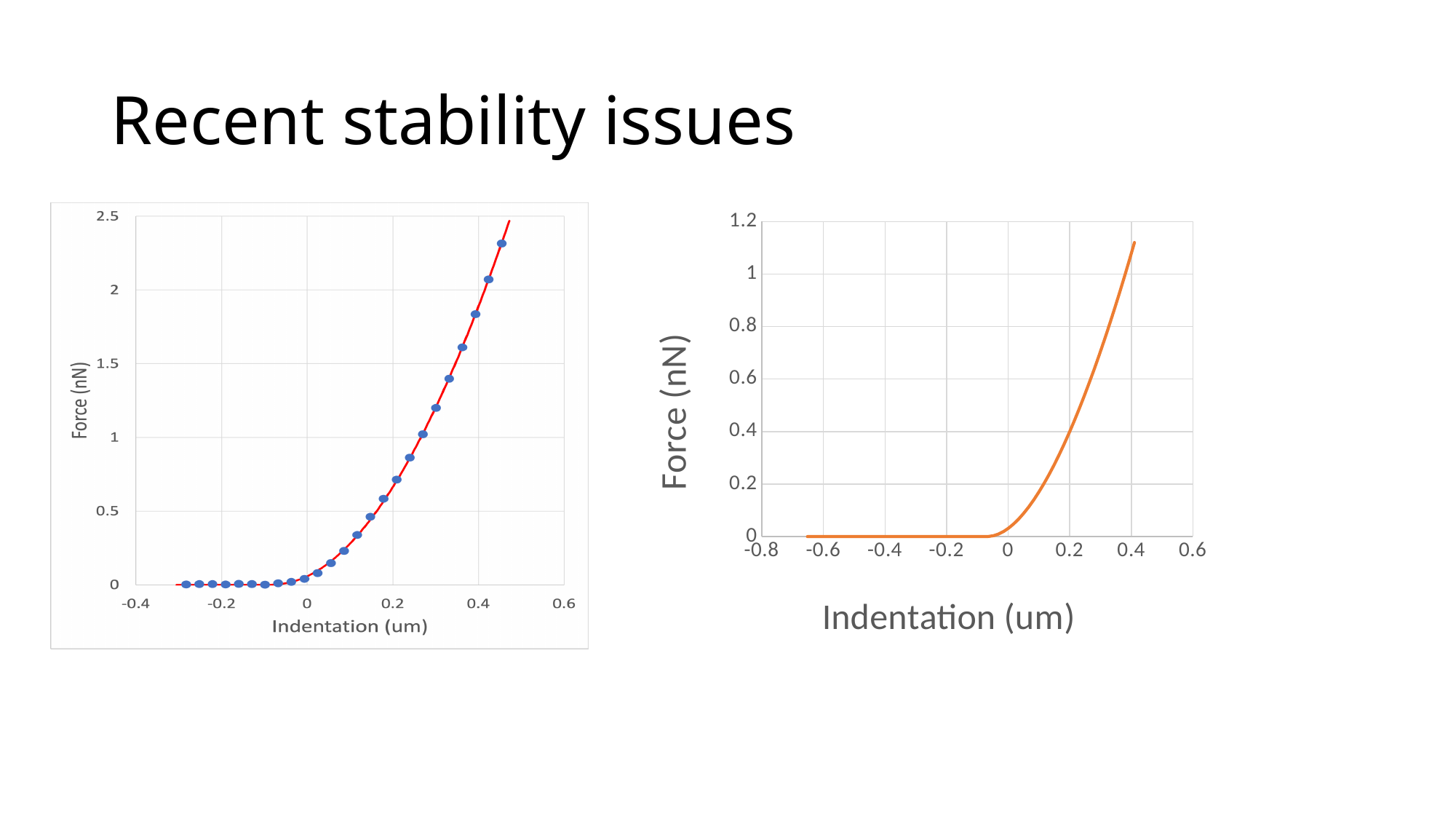
In the chart on the right, is the force at an indentation of -0.4 um greater or less than 0.2 nN? less What is the label of the y axis on the chart on the right? Force (nN) In the chart on the left, is the force at an indentation of 0.4 um greater or less than 1.5 nN? greater What kind of chart is the chart on the left of the slide? scatter chart with a fitted line In the chart on the left, does the force rise or fall as indentation increases from 0 to 0.4 um? rise In the chart on the left, is the force at an indentation of 0.2 um greater or less than 1 nN? less What colour is the line plotted in the chart on the right? orange In the chart on the right, does the force rise or fall as indentation increases from 0 to 0.4 um? rise What kind of chart is the chart on the right of the slide? line chart